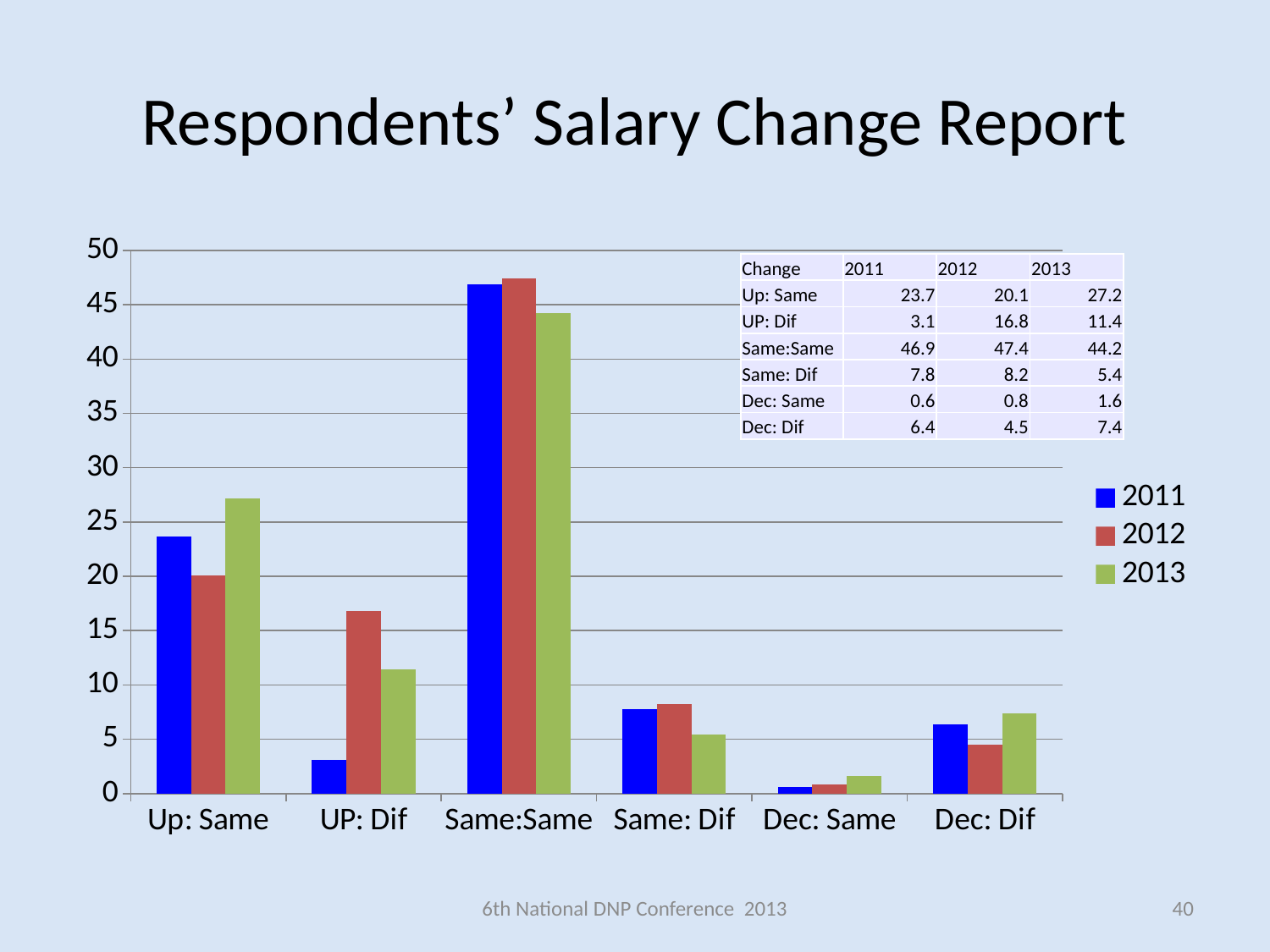
Which category has the lowest 2011 value? Dec: Same What is the difference between the 2013 and 2012 values for Up: Same? 7.1 How many series does the legend list? 3 How many categories are shown on the x axis? 6 What is the 2013 value for Same:Same? 44.2 Is the 2011 value for Same:Same greater or less than 45? greater What is the title of the chart? Respondents' Salary Change Report What kind of chart is shown on the slide? bar chart Which category has the highest 2012 value? Same:Same What is the 2012 value for Dec: Dif? 4.5 What is the 2011 value for UP: Dif? 3.1 Which is larger for UP: Dif, the 2012 value or the 2013 value? 2012